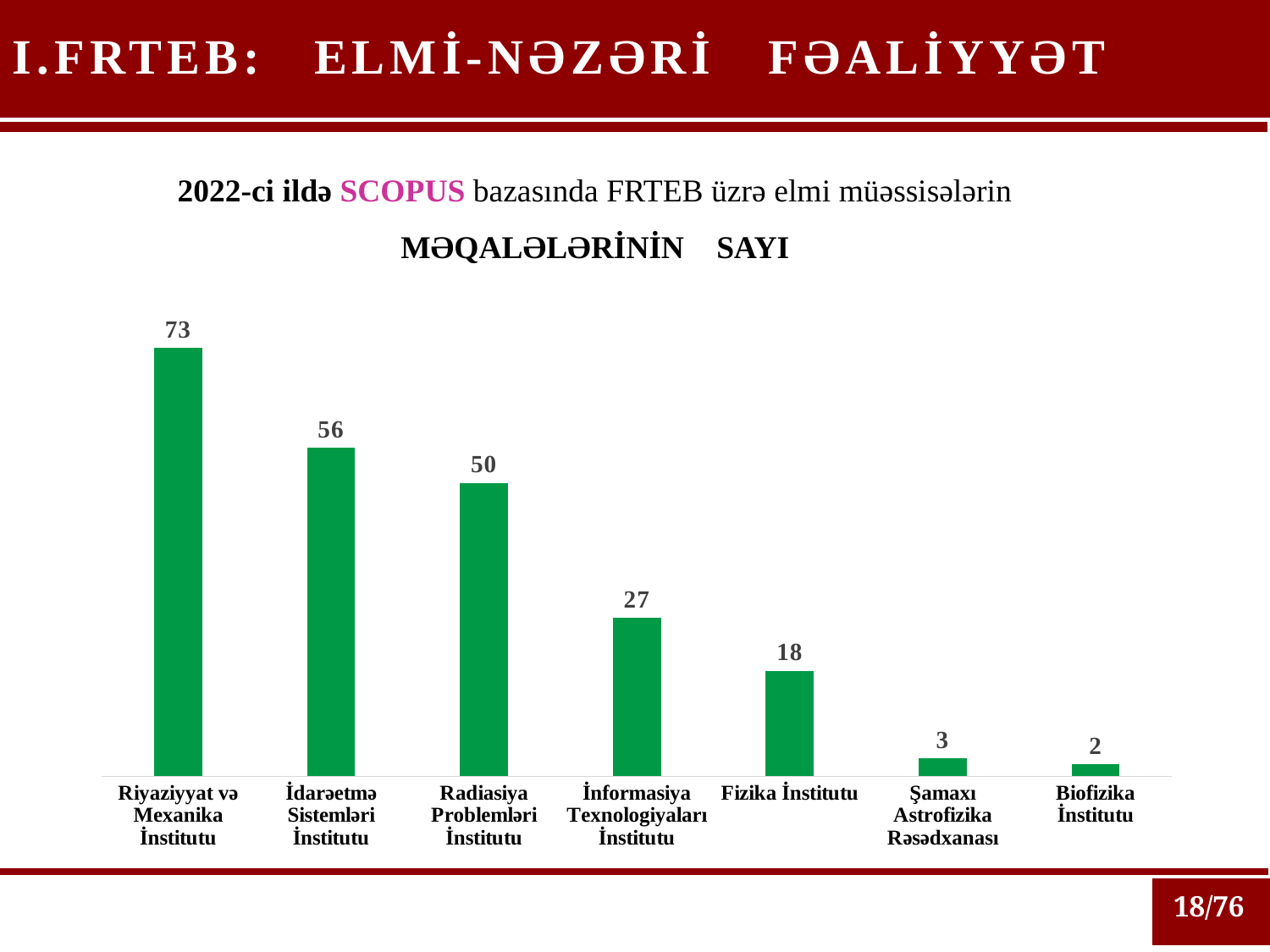
How many institutes are shown in the chart? 7 What is the difference between the values for Riyaziyyat və Mexanika İnstitutu and İnformasiya Texnologiyaları İnstitutu? 46 What kind of chart is shown on the slide? Bar chart What colour are the bars in the chart? Green Which institute has the highest number of articles? Riyaziyyat və Mexanika İnstitutu What is the value shown for Fizika İnstitutu? 18 How many Scopus articles does the Riyaziyyat və Mexanika İnstitutu have? 73 Do the values rise or fall from left to right across the chart? Fall What is the value shown for Şamaxı Astrofizika Rəsədxanası? 3 What is the difference between the values for İdarəetmə Sistemləri İnstitutu and Radiasiya Problemləri İnstitutu? 6 Which has a larger value, İnformasiya Texnologiyaları İnstitutu or Fizika İnstitutu? İnformasiya Texnologiyaları İnstitutu Which institute has the lowest number of articles? Biofizika İnstitutu